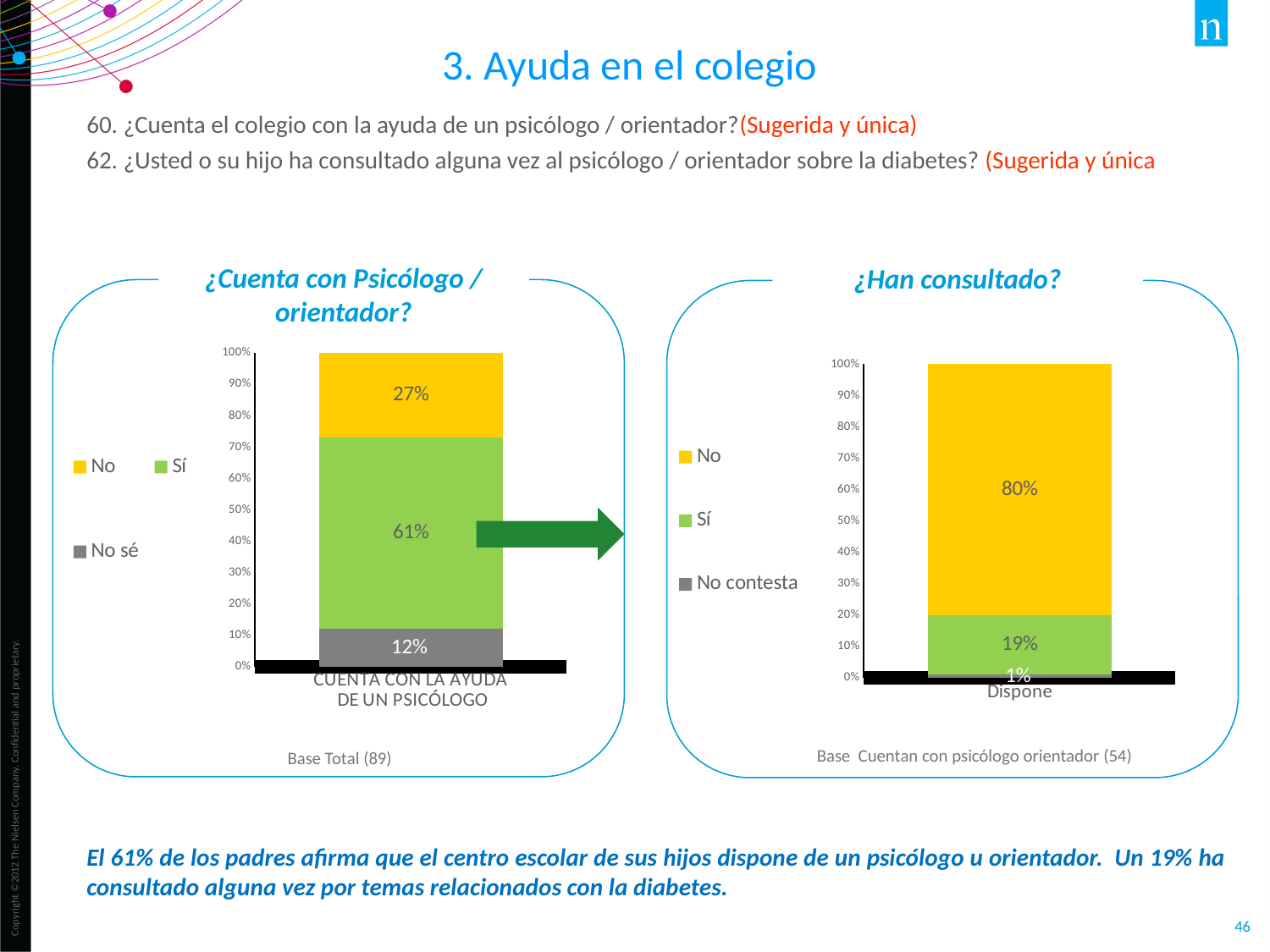
In the '¿Han consultado?' chart, which response has the smallest share? No contesta In the '¿Cuenta con Psicólogo / orientador?' chart, what percentage is shown for 'No'? 27% In the '¿Han consultado?' chart, what is the difference between the 'No' and 'Sí' percentages? 61% What type of chart is the '¿Cuenta con Psicólogo / orientador?' chart? Stacked bar chart In the '¿Cuenta con Psicólogo / orientador?' chart, what percentage is shown for 'No sé'? 12% In the '¿Han consultado?' chart, what percentage is shown for 'No contesta'? 1% How many series does the legend of the '¿Han consultado?' chart list? 3 In the '¿Han consultado?' chart, what percentage is shown for 'No'? 80% In the '¿Cuenta con Psicólogo / orientador?' chart, which response has the largest share? Sí In the '¿Cuenta con Psicólogo / orientador?' chart, what is the difference between the 'Sí' and 'No' percentages? 34% In the '¿Cuenta con Psicólogo / orientador?' chart, what percentage is shown for 'Sí'? 61% In the '¿Han consultado?' chart, what percentage is shown for 'Sí'? 19%